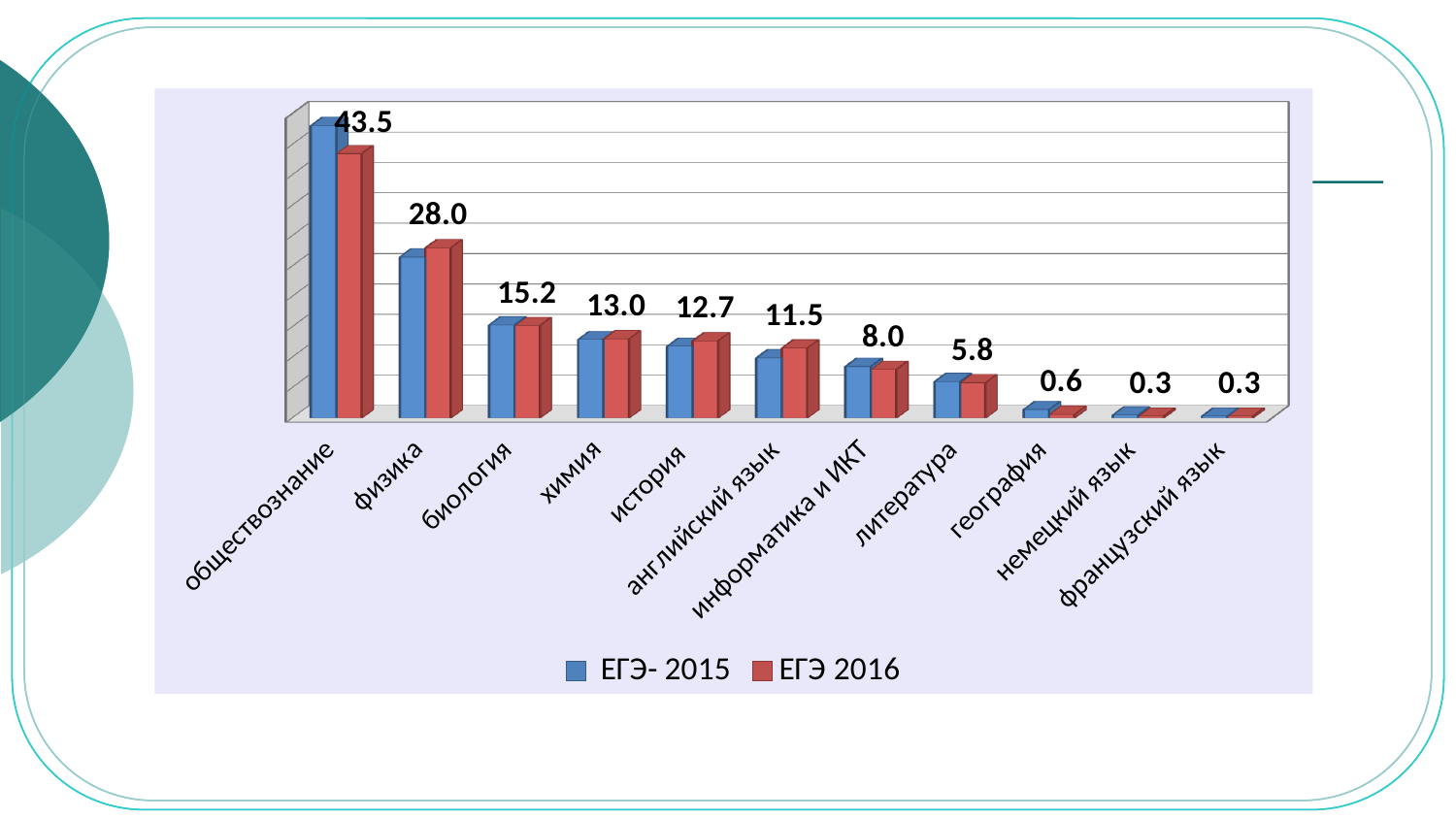
What data label is printed above the bars for физика? 28.0 How many subject categories are shown on the x axis? 11 What data label is printed above the bars for биология? 15.2 Do the bar heights generally rise or fall moving from left to right along the x axis? fall For обществознание, which series has the taller bar, ЕГЭ- 2015 or ЕГЭ 2016? ЕГЭ- 2015 What data label is printed above the bars for информатика и ИКТ? 8.0 For физика, which series has the taller bar, ЕГЭ- 2015 or ЕГЭ 2016? ЕГЭ 2016 Which subject has the highest bars in the chart? обществознание What data label is printed above the bars for география? 0.6 How many series does the legend list? 2 What colour are the bars for the ЕГЭ 2016 series? red What kind of chart is shown on the slide? bar chart